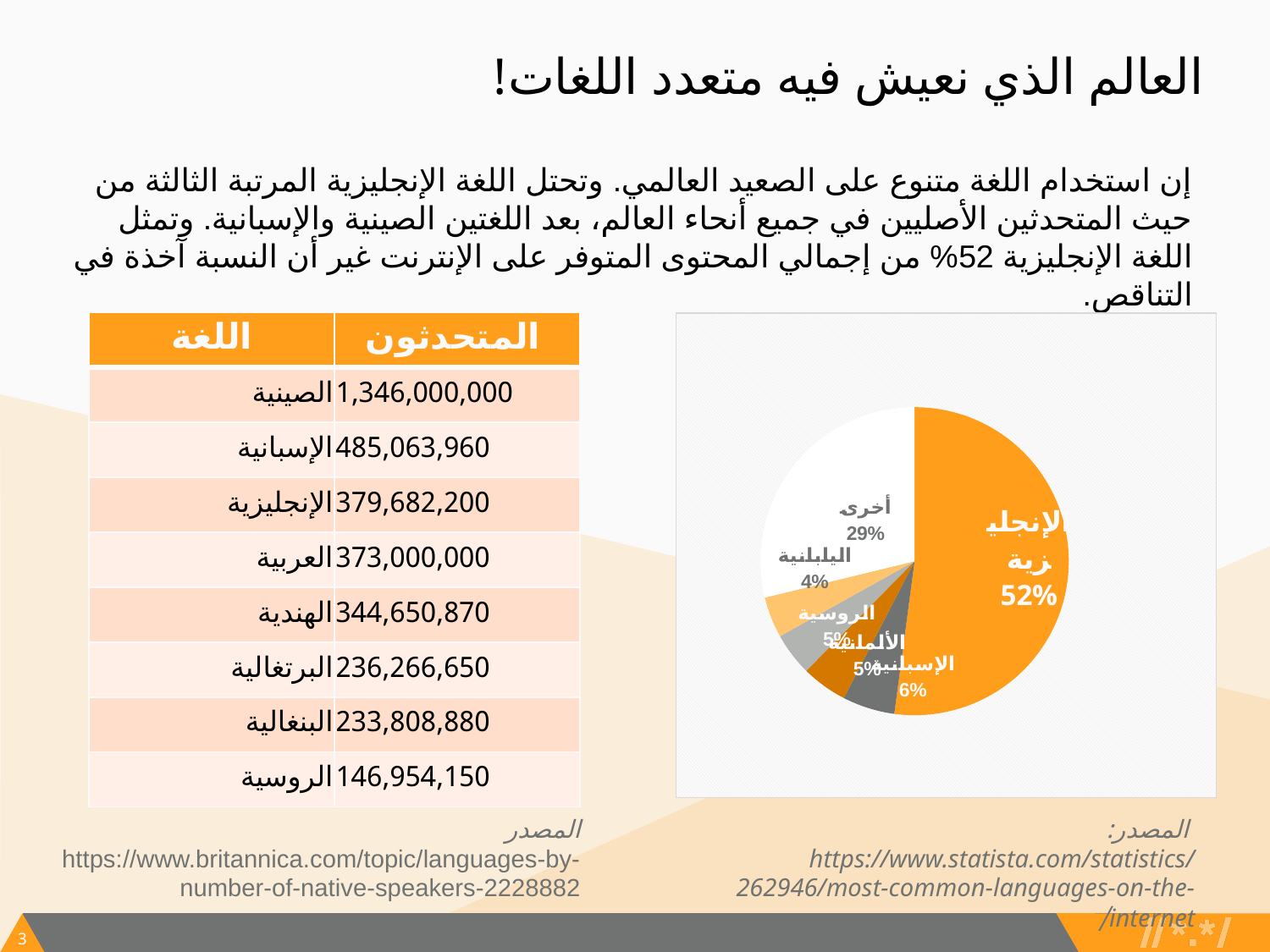
What is the difference in percentage points between الإنجليزية (52%) and أخرى (29%) in the pie chart? 23% What kind of chart is shown on the slide? pie chart What percentage is shown for أخرى (Other) in the pie chart? 29% What share of the pie chart does الإنجليزية (English) have? 52% What percentage is shown for الإسبانية (Spanish) in the pie chart? 6% Which labelled slice of the pie chart is the smallest? اليابانية Which is larger in the pie chart, الإنجليزية or أخرى? الإنجليزية How many slices does the pie chart have? 6 Which is larger in the pie chart, الإسبانية or اليابانية? الإسبانية Which slice of the pie chart is the largest? الإنجليزية What colour is the largest slice of the pie chart? orange What percentage is shown for اليابانية (Japanese) in the pie chart? 4%